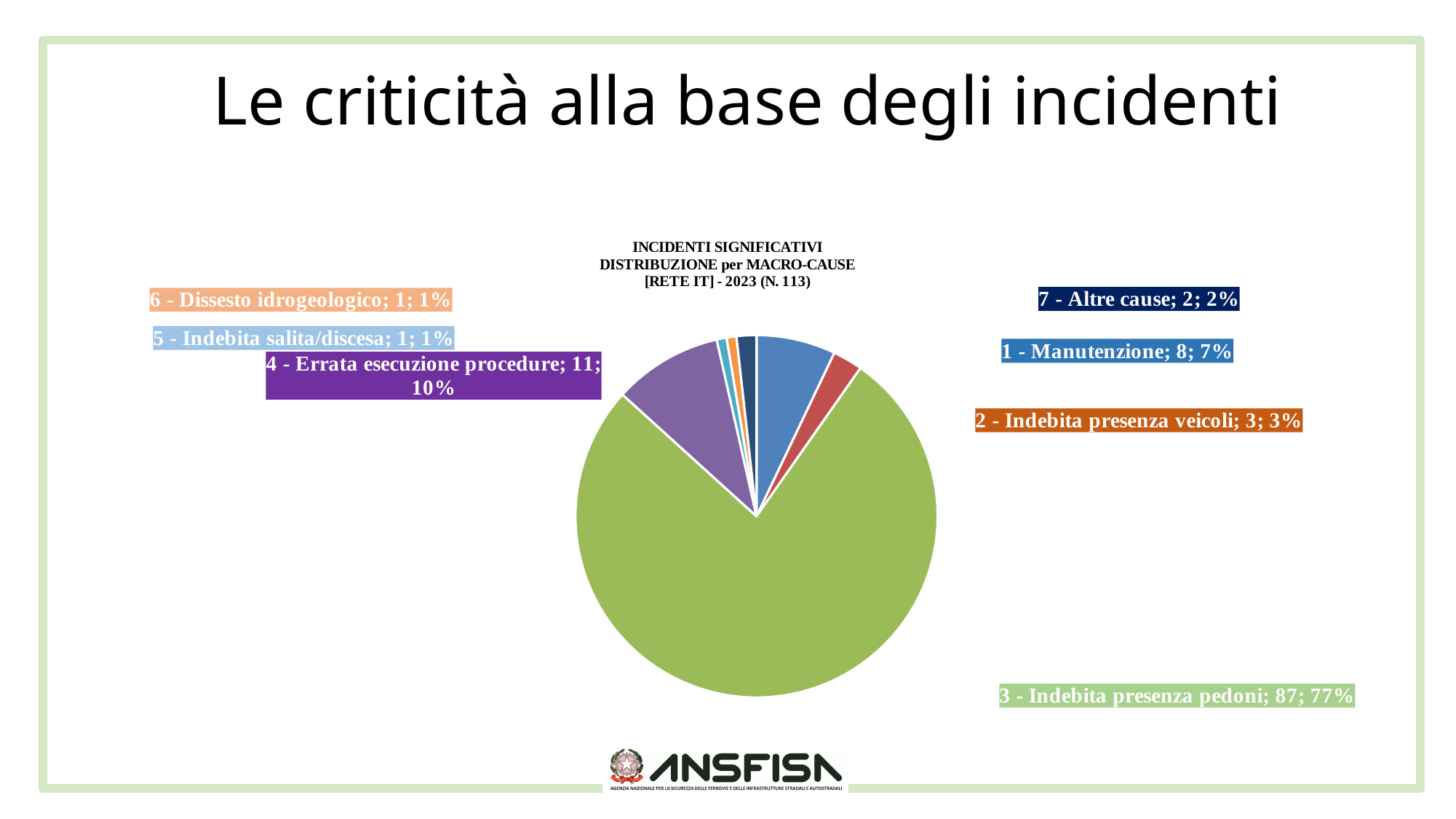
What kind of chart is shown on the slide? pie chart What year does the chart title say the data refers to? 2023 What is the difference in number of incidents between '4 - Errata esecuzione procedure' and '1 - Manutenzione'? 3 What is the total number of incidents (N.) stated in the chart title? 113 Which has more incidents, '2 - Indebita presenza veicoli' or '7 - Altre cause'? 2 - Indebita presenza veicoli How many incidents are attributed to '7 - Altre cause'? 2 How many incidents are attributed to '3 - Indebita presenza pedoni'? 87 What percentage share does '2 - Indebita presenza veicoli' have in the pie chart? 3% What percentage share does '4 - Errata esecuzione procedure' have in the pie chart? 10% Which macro-cause has the largest slice of the pie chart? 3 - Indebita presenza pedoni How many macro-cause categories are shown in the pie chart? 7 How many incidents are attributed to '1 - Manutenzione'? 8